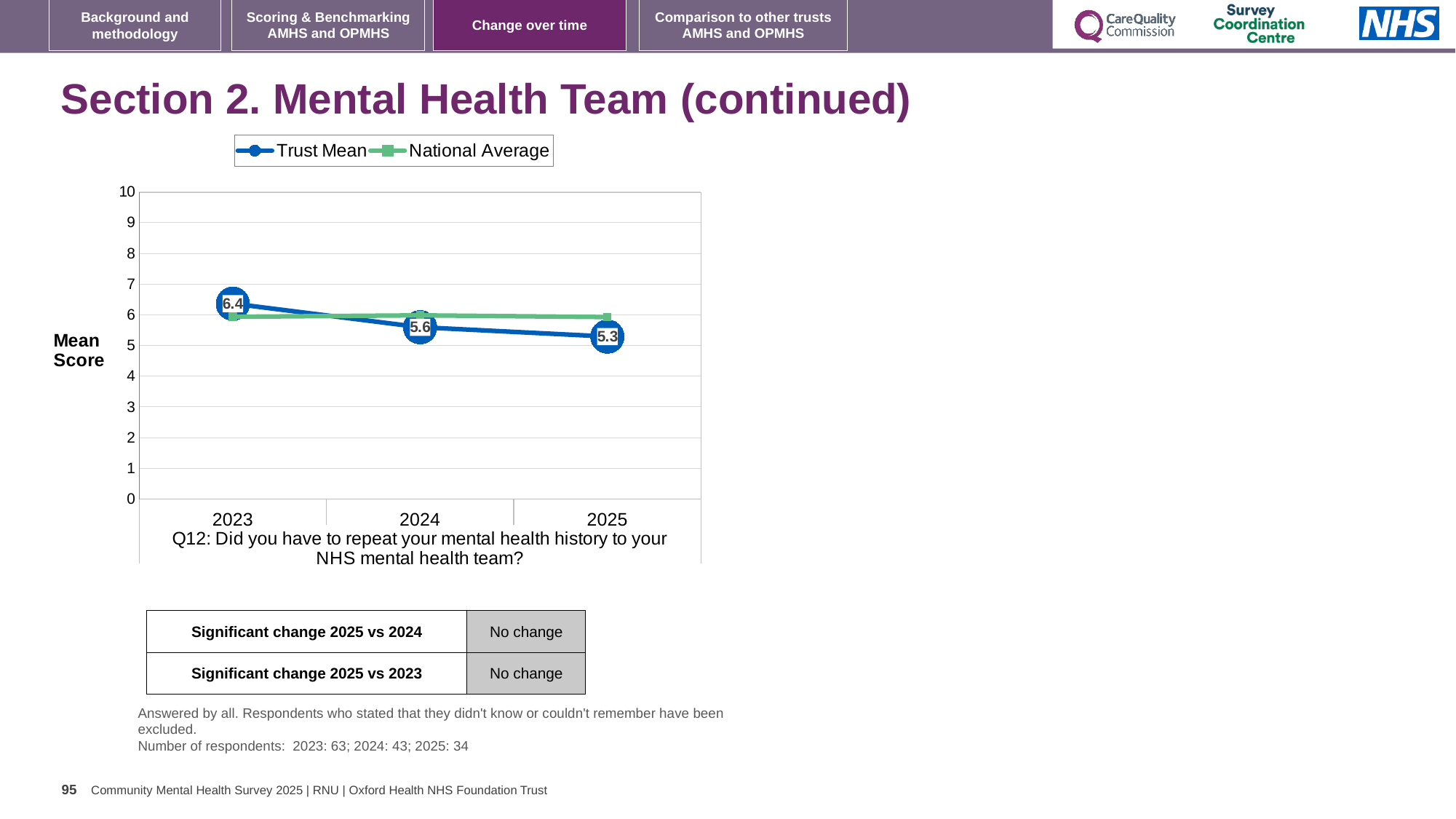
What is the Trust Mean value for 2023? 6.4 In which year is the Trust Mean highest? 2023 In 2025, which is larger: the Trust Mean or the National Average? National Average What is the difference between the Trust Mean in 2023 and in 2025? 1.1 In which year is the Trust Mean lowest? 2025 Does the Trust Mean rise or fall from 2023 to 2025? fall What is the Trust Mean value for 2024? 5.6 How many years are shown on the x axis of the chart? 3 What is the Trust Mean value for 2025? 5.3 Is the National Average value for 2025 greater or less than 5? greater In 2023, which is larger: the Trust Mean or the National Average? Trust Mean How many series does the chart legend list? 2